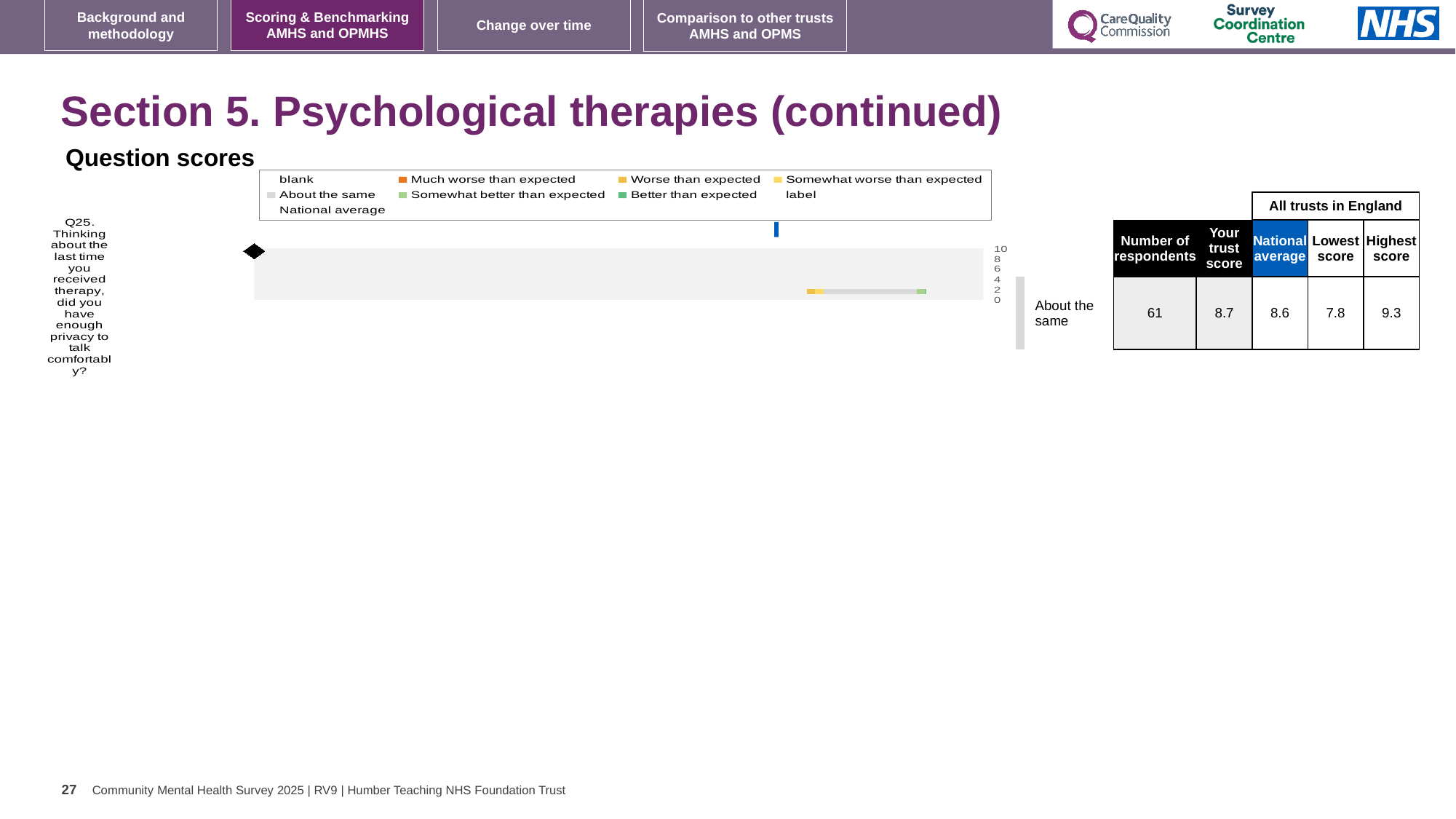
Which legend entry is shown in orange? Much worse than expected Which question is plotted in the chart? Q25. Thinking about the last time you received therapy, did you have enough privacy to talk comfortably? What benchmark category label is shown next to the bar for Q25? About the same How many questions are plotted in the 'Question scores' chart? 1 What is the highest value shown on the chart's axis? 10 What kind of chart is shown under 'Question scores'? bar chart